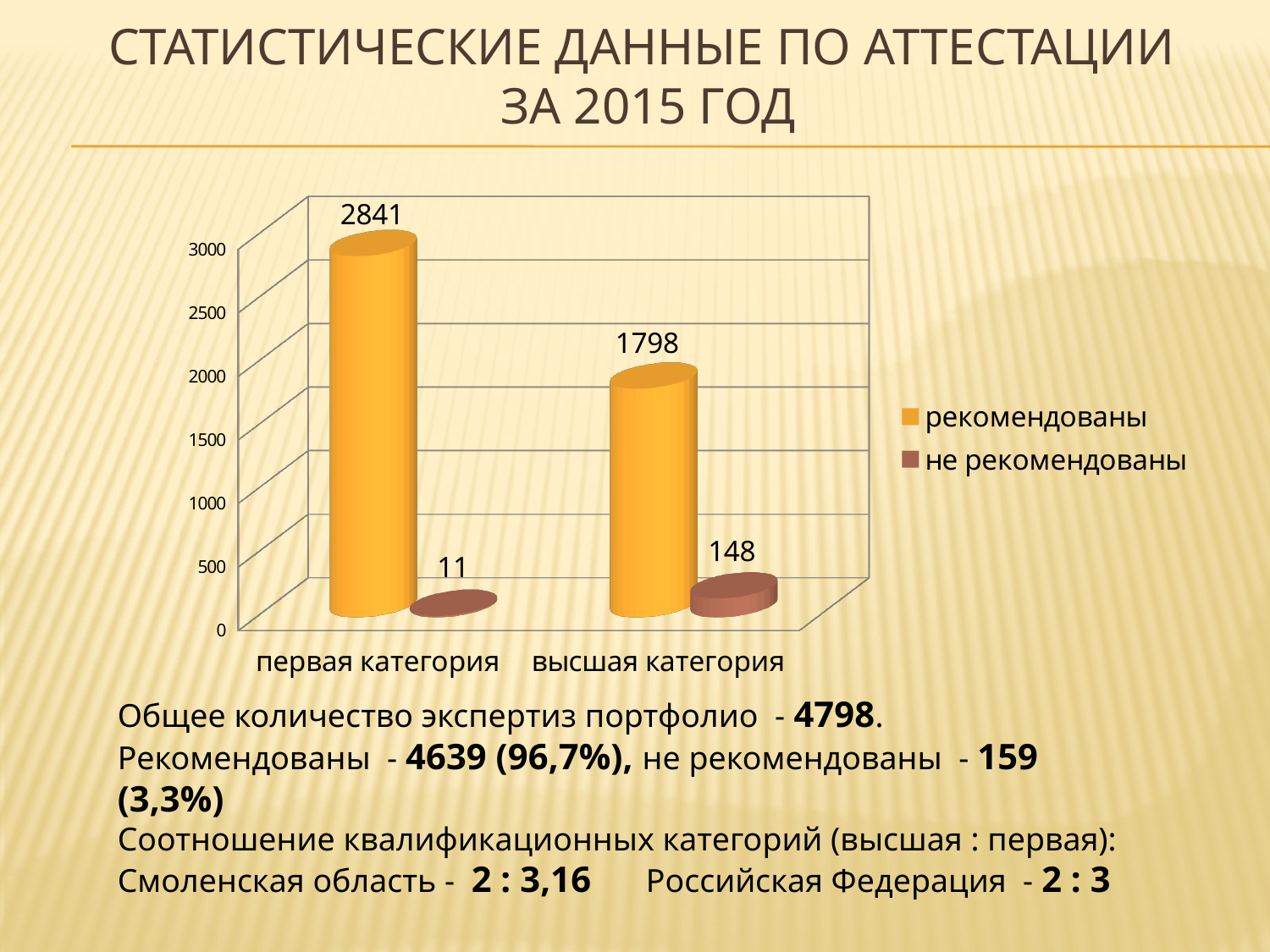
Which is larger: 'рекомендованы' for 'высшая категория' or 'рекомендованы' for 'первая категория'? первая категория What is the value for 'рекомендованы' in the 'высшая категория' category? 1798 Which category has the highest value for 'рекомендованы'? первая категория What is the value for 'рекомендованы' in the 'первая категория' category? 2841 What kind of chart is shown on the slide? bar chart Which category has the lowest value for 'не рекомендованы'? первая категория What is the value for 'не рекомендованы' in the 'высшая категория' category? 148 What is the difference between the 'не рекомендованы' values for 'высшая категория' and 'первая категория'? 137 How many categories are shown on the x axis? 2 What is the value for 'не рекомендованы' in the 'первая категория' category? 11 What is the difference between the 'рекомендованы' values for 'первая категория' and 'высшая категория'? 1043 How many series does the legend list? 2